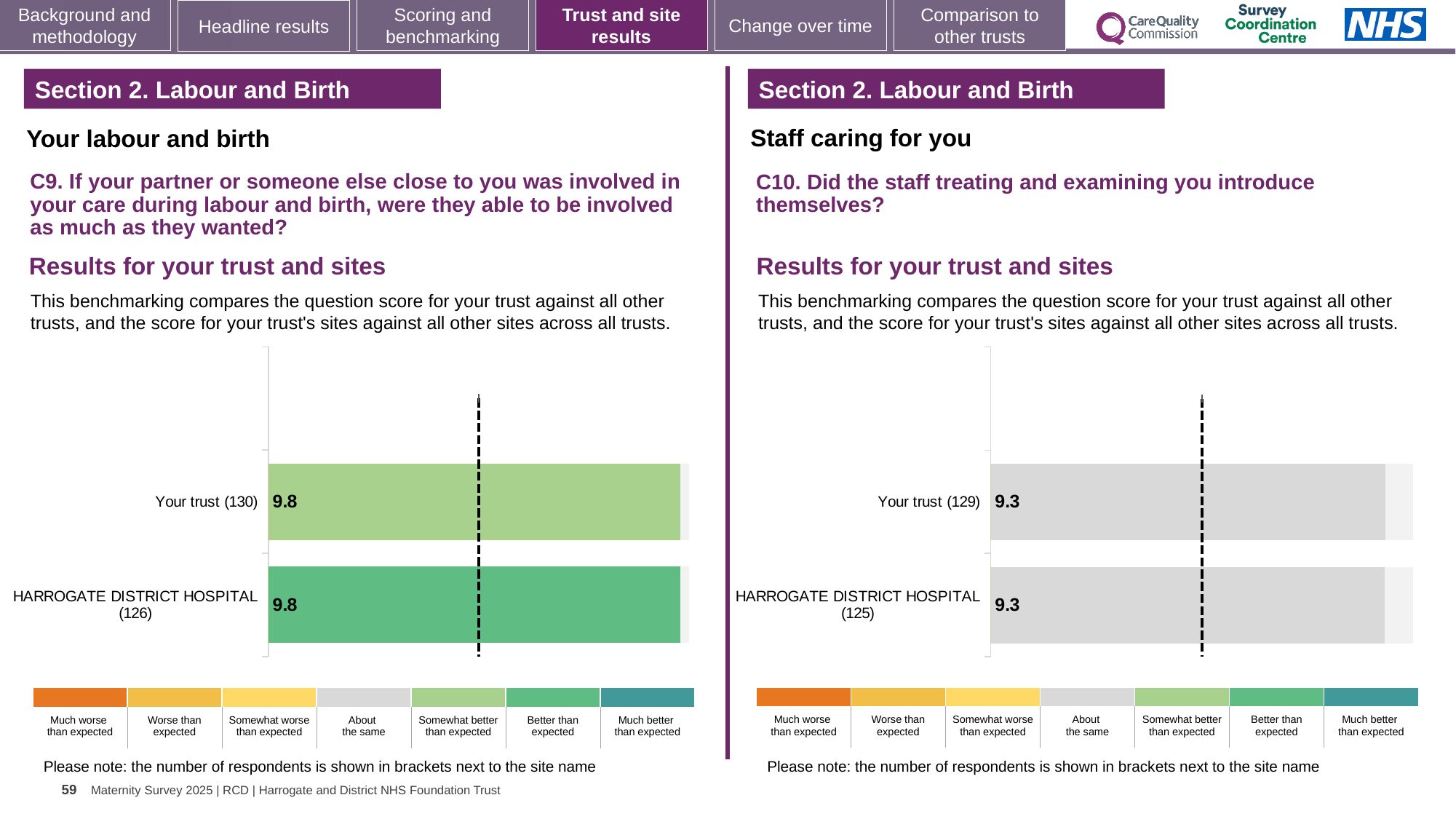
On the C9 chart (left), what is the difference between the score for Your trust and the score for HARROGATE DISTRICT HOSPITAL? 0.0 On the C10 chart (right), which benchmark category does the colour of the Your trust bar correspond to in the legend? About the same What type of chart is used on the C9 chart (left)? Bar chart On the C10 chart (right), what is the score for HARROGATE DISTRICT HOSPITAL (125)? 9.3 On the C10 chart (right), what is the difference between the score for Your trust and the score for HARROGATE DISTRICT HOSPITAL? 0.0 How many bars are plotted on the C9 chart (left)? 2 On the C9 chart (left), which benchmark category does the colour of the HARROGATE DISTRICT HOSPITAL bar correspond to in the legend? Better than expected On the C9 chart (left), what is the score for Your trust (130)? 9.8 On the C10 chart (right), what is the score for Your trust (129)? 9.3 How many respondents are shown in brackets for Your trust on the C10 chart (right)? 129 How many bars are plotted on the C10 chart (right)? 2 On the C9 chart (left), what is the score for HARROGATE DISTRICT HOSPITAL (126)? 9.8